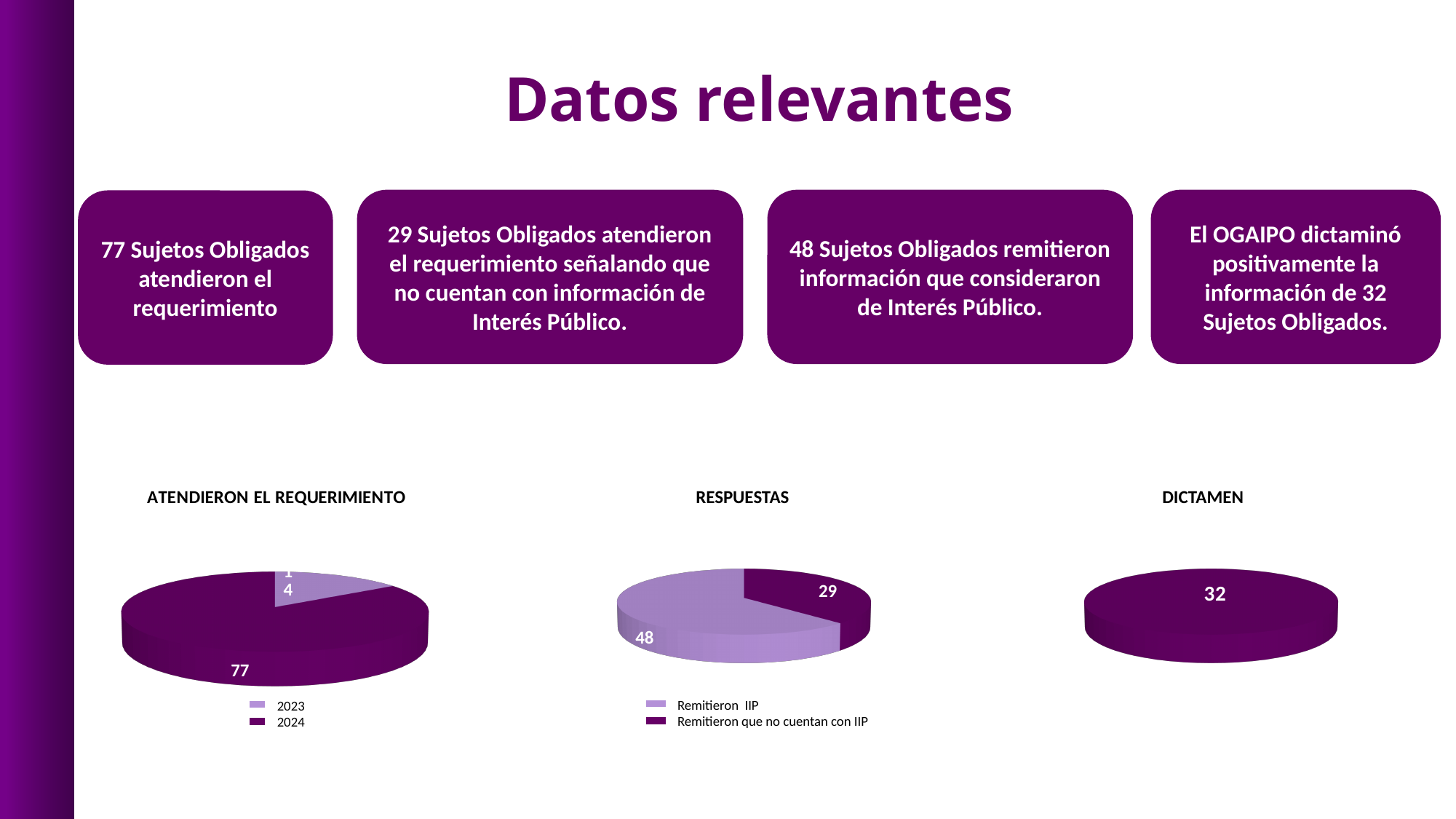
In the ATENDIERON EL REQUERIMIENTO chart, which year has the smaller slice? 2023 How many series does the legend of the ATENDIERON EL REQUERIMIENTO chart list? 2 What type of chart is the RESPUESTAS chart? pie chart In the RESPUESTAS chart, is the value for 'Remitieron IIP' larger or smaller than the value for 'Remitieron que no cuentan con IIP'? larger In the ATENDIERON EL REQUERIMIENTO chart, what is the value for 2024? 77 In the DICTAMEN chart, what value is shown on the pie? 32 How many slices does the DICTAMEN chart have? 1 What is the title of the chart on the right of the slide? DICTAMEN In the RESPUESTAS chart, which category has the larger value? Remitieron IIP In the RESPUESTAS chart, what is the value for 'Remitieron que no cuentan con IIP'? 29 In the RESPUESTAS chart, what is the value for 'Remitieron IIP'? 48 In the RESPUESTAS chart, what is the difference between 'Remitieron IIP' and 'Remitieron que no cuentan con IIP'? 19